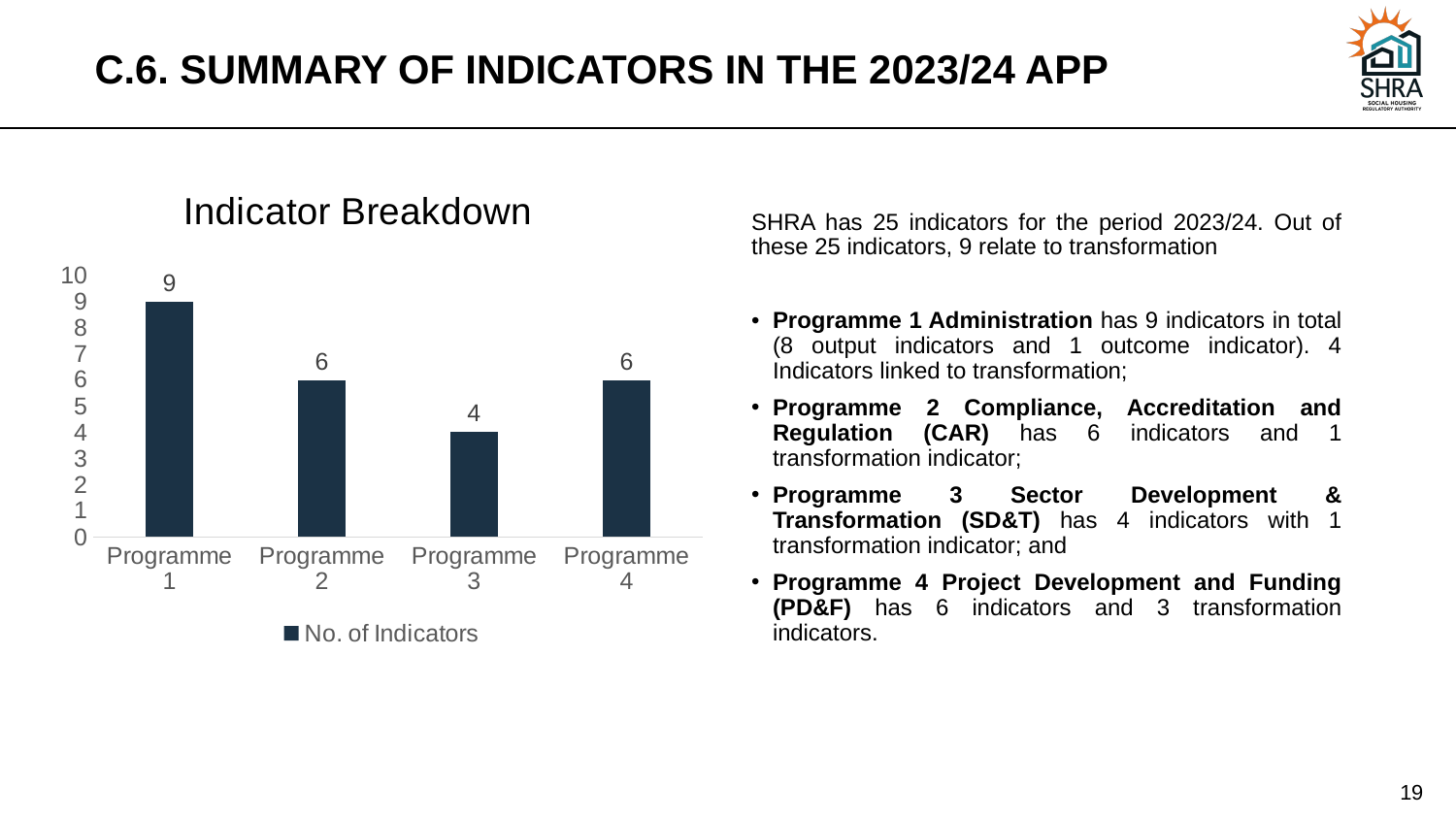
Which programme has the lowest number of indicators? Programme 3 How many series does the chart legend list? 1 Which has more indicators, Programme 2 or Programme 3? Programme 2 How many programmes are shown on the x axis of the chart? 4 What kind of chart is shown on the slide? bar chart Which programme has the highest number of indicators? Programme 1 Is the value for Programme 1 greater or less than 8? greater What is the title of the chart? Indicator Breakdown What is the number of indicators for Programme 4? 6 What is the number of indicators for Programme 3? 4 What is the difference in the number of indicators between Programme 1 and Programme 3? 5 What is the number of indicators for Programme 1? 9